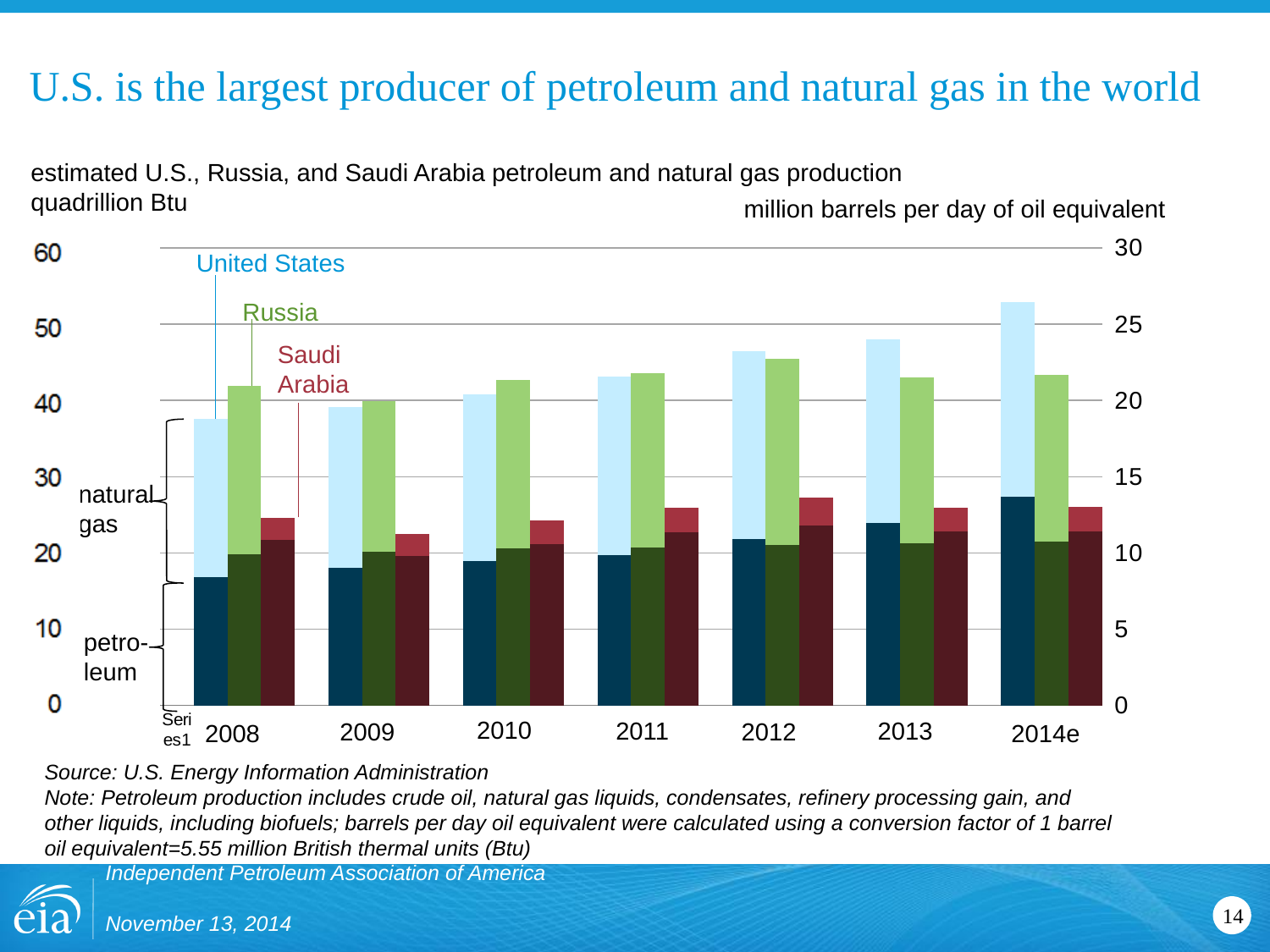
Which country has the tallest bar in 2014e? United States Is the total Saudi Arabia bar for 2008 greater or less than 30 quadrillion Btu? less What unit is shown on the right axis of the chart? million barrels per day of oil equivalent Which country has the shortest bar in every year shown? Saudi Arabia In 2008, which bar is taller: United States or Russia? Russia What unit is shown on the left axis of the chart? quadrillion Btu How many years are shown along the x axis of the chart? 7 What kind of chart is shown on the slide? stacked bar chart How many countries are labeled in the chart? 3 Is the total United States bar for 2014e greater or less than 50 quadrillion Btu? greater Does the total United States bar rise or fall from 2008 to 2014e? rise In 2014e, which bar is taller: United States or Russia? United States